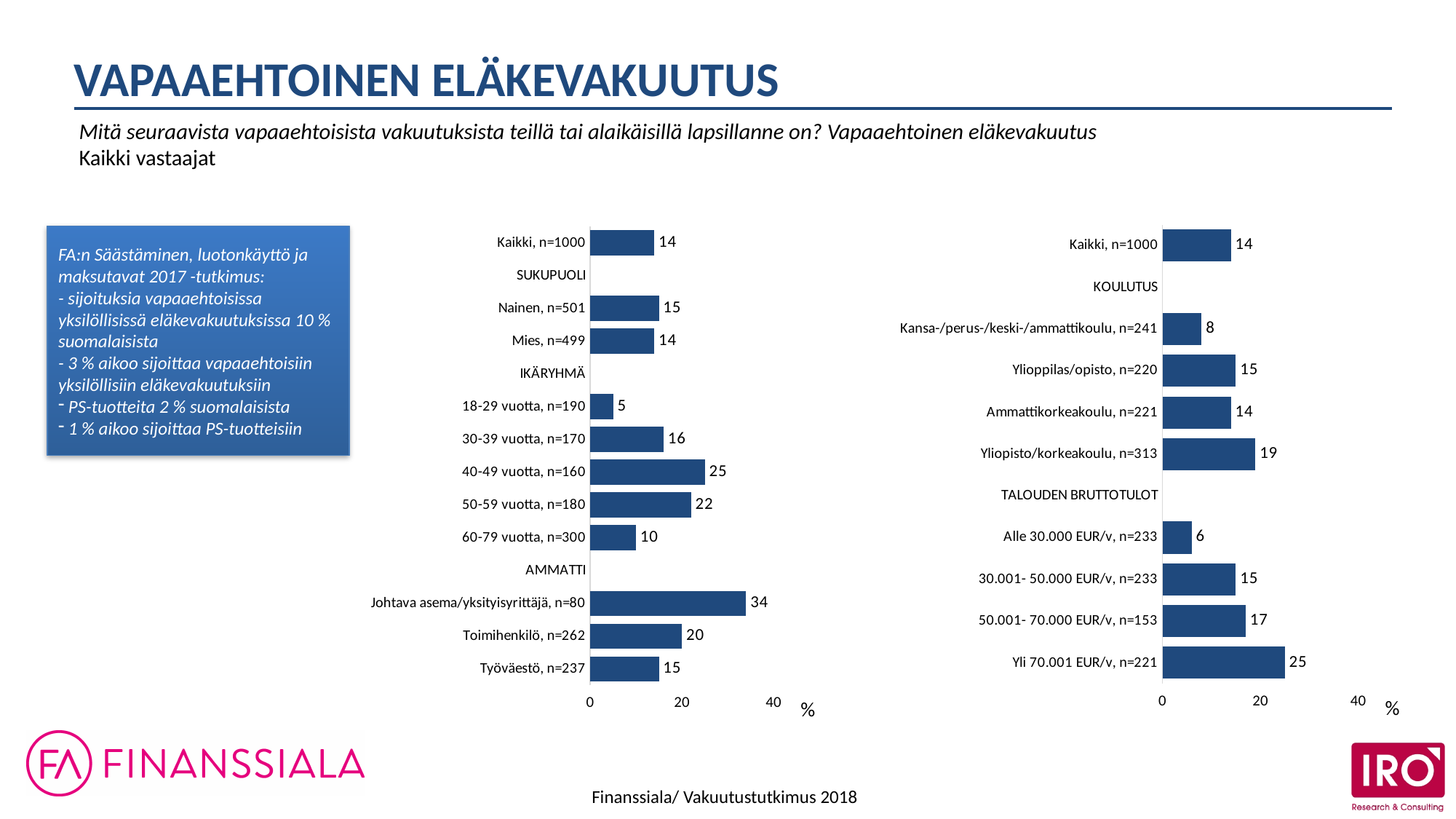
In the left chart, which is larger: the value for Nainen, n=501 or Mies, n=499? Nainen, n=501 What kind of chart is the left chart? bar chart In the left chart, what is the value for 18-29 vuotta, n=190? 5 In the left chart, which age group (IKÄRYHMÄ) has the highest value? 40-49 vuotta, n=160 In the left chart, what is the value for Johtava asema/yksityisyrittäjä, n=80? 34 In the left chart, what is the difference between the values for Toimihenkilö, n=262 and Työväestö, n=237? 5 In the right chart, do the values rise or fall as household gross income (TALOUDEN BRUTTOTULOT) increases? rise In the right chart, what is the value for Yliopisto/korkeakoulu, n=313? 19 In the right chart, is the value for Yliopisto/korkeakoulu, n=313 greater or less than 20? less In the right chart, which category has the lowest value? Alle 30.000 EUR/v, n=233 In the right chart, what is the difference between the values for Yli 70.001 EUR/v, n=221 and 50.001- 70.000 EUR/v, n=153? 8 In the right chart, what is the value for Alle 30.000 EUR/v, n=233? 6